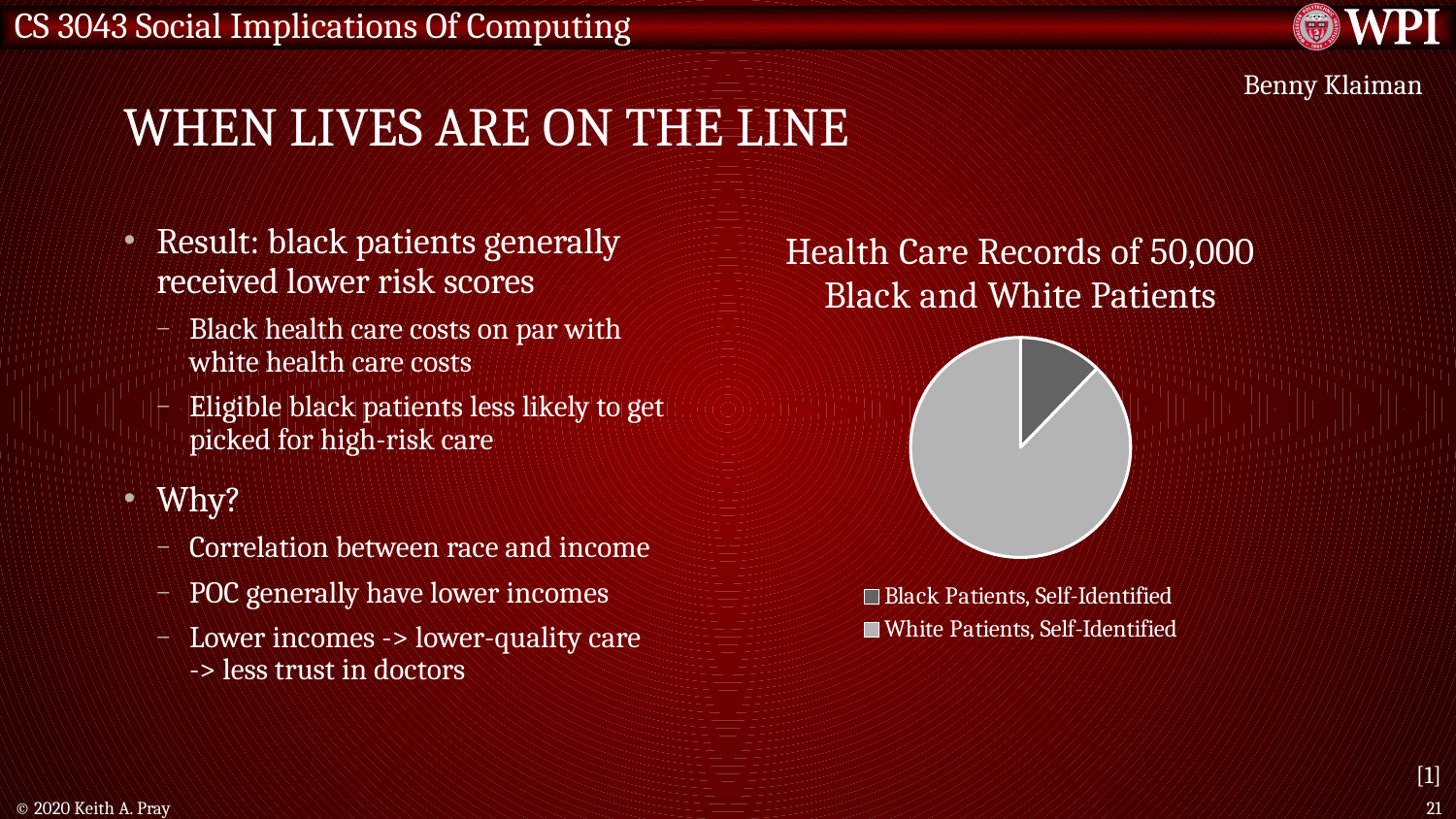
Which slice of the pie chart is the smallest? Black Patients, Self-Identified Which legend entry is shown in the darker gray colour in the pie chart? Black Patients, Self-Identified What kind of chart is shown on the slide? Pie chart How many entries does the chart's legend list? 2 Which is larger in the pie chart: the slice for Black Patients, Self-Identified or the slice for White Patients, Self-Identified? White Patients, Self-Identified What is the title of the chart on the slide? Health Care Records of 50,000 Black and White Patients Which slice of the pie chart is the largest? White Patients, Self-Identified How many slices does the pie chart have? 2